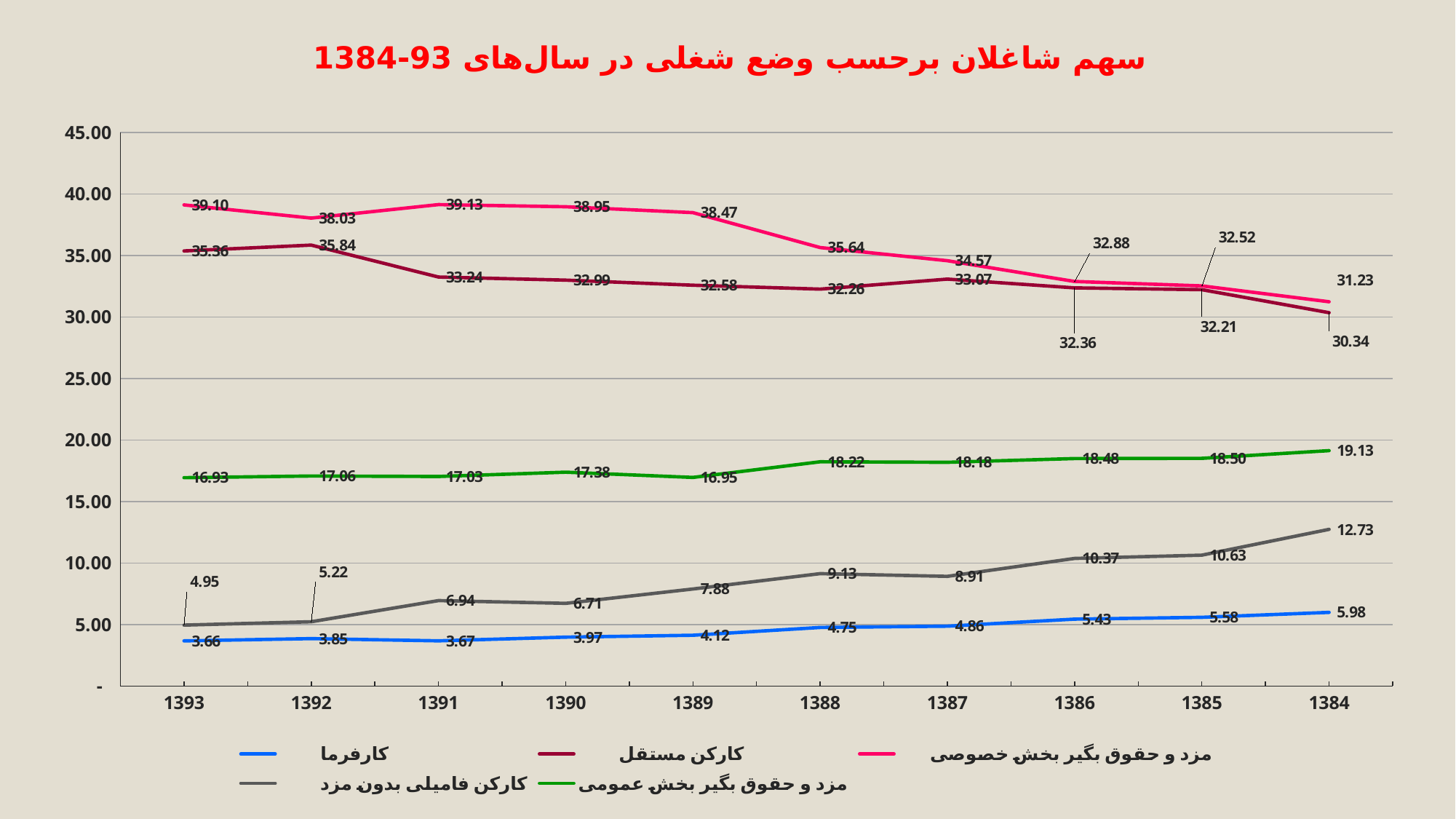
How many years are shown on the x axis? 10 What is the value of the کارفرما series in 1384? 5.98 How many series does the legend list? 5 What is the value of the کارکن فامیلی بدون مزد series in 1388? 9.13 What is the difference between the مزد و حقوق بگیر بخش خصوصی value in 1393 and in 1384? 7.87 Which series has the larger value in 1392: کارکن مستقل or مزد و حقوق بگیر بخش عمومی? کارکن مستقل What is the title of the chart? سهم شاغلان برحسب وضع شغلی در سال‌های 1384-93 In which year does the کارفرما series have its lowest value? 1393 What is the value of the مزد و حقوق بگیر بخش خصوصی series in 1391? 39.13 Does the کارکن فامیلی بدون مزد series generally rise or fall from 1393 to 1384? rise In which year does the کارکن فامیلی بدون مزد series reach its highest value? 1384 What kind of chart is shown on the slide? line chart